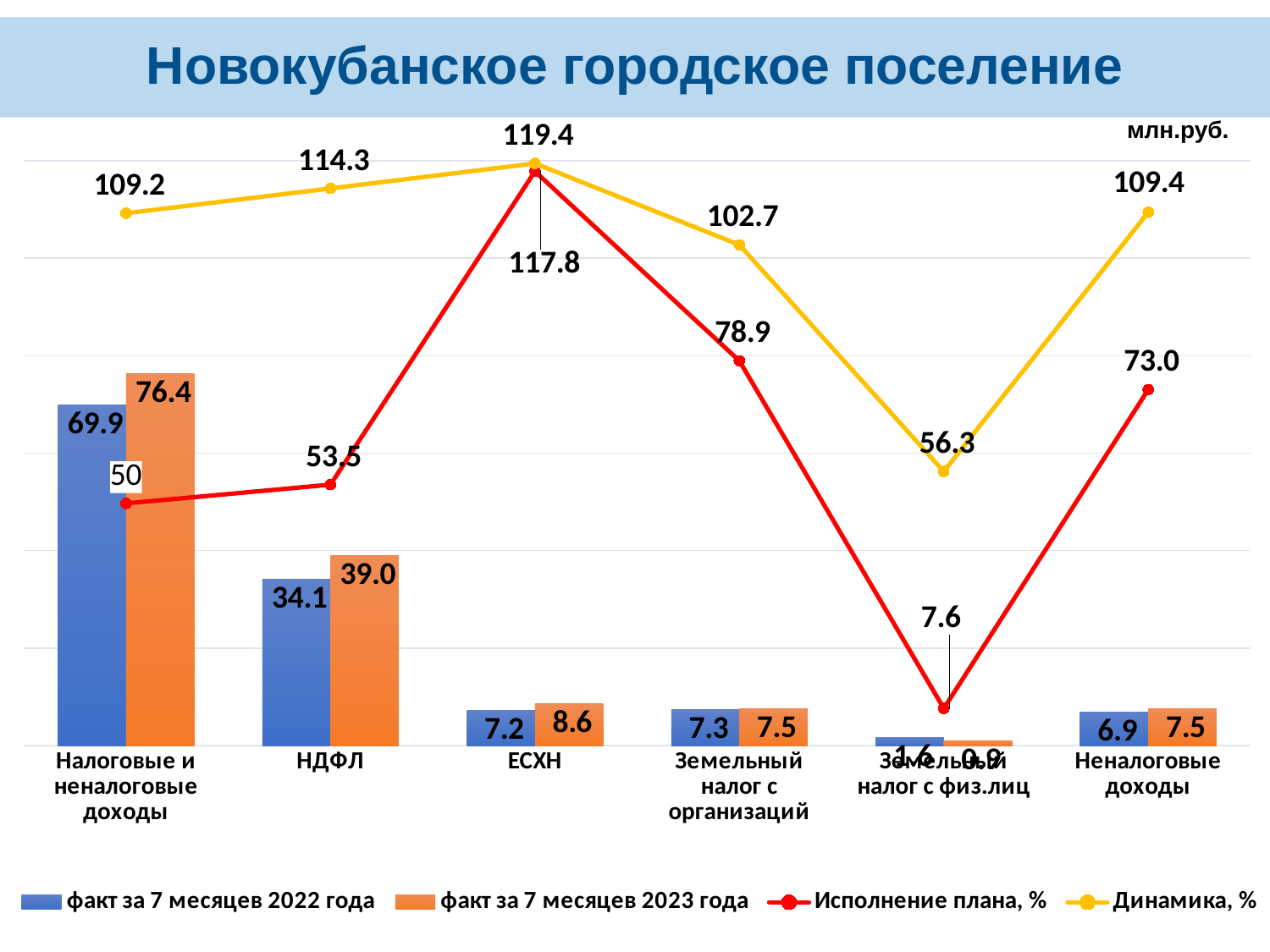
What is the 'Исполнение плана, %' value for Земельный налог с организаций? 78.9 Which category has the lowest 'Динамика, %' value? Земельный налог с физ.лиц What is the value of 'факт за 7 месяцев 2023 года' for НДФЛ? 39.0 What is the value of 'факт за 7 месяцев 2022 года' for Налоговые и неналоговые доходы? 69.9 What is the difference between 'факт за 7 месяцев 2023 года' and 'факт за 7 месяцев 2022 года' for Налоговые и неналоговые доходы? 6.5 What unit is indicated in the top right corner of the chart? млн.руб. How many categories are shown on the x axis? 6 What kind of chart is this? Combined bar and line chart What is the 'Динамика, %' value for ЕСХН? 119.4 How many series does the legend list? 4 Which category has the highest 'Исполнение плана, %' value? ЕСХН Which is larger for Неналоговые доходы: 'Исполнение плана, %' or 'Динамика, %'? Динамика, %